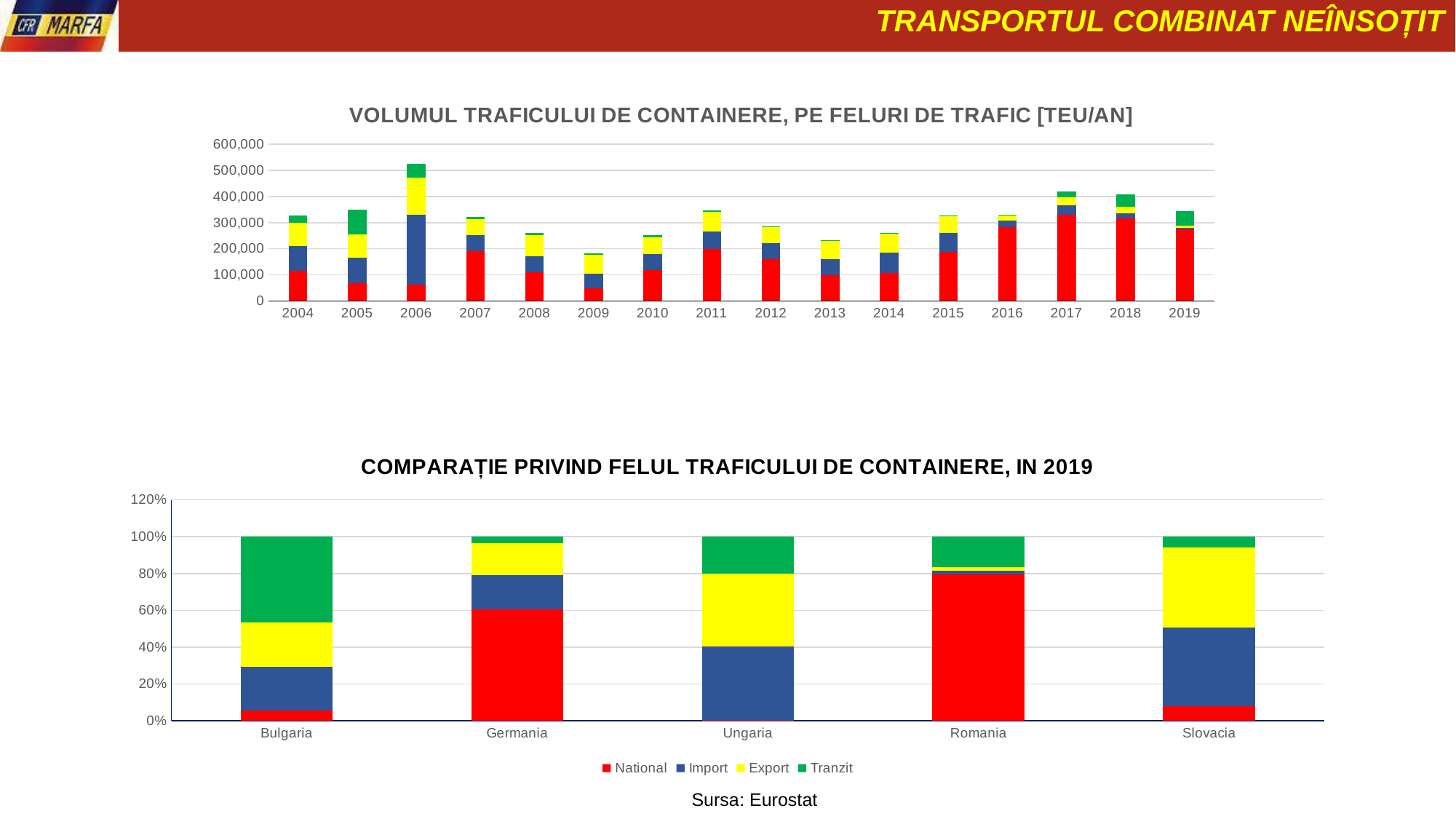
In the bottom chart, 'COMPARAȚIE PRIVIND FELUL TRAFICULUI DE CONTAINERE, IN 2019', which country has the largest National share? Romania What kind of chart is the top chart, 'VOLUMUL TRAFICULUI DE CONTAINERE, PE FELURI DE TRAFIC [TEU/AN]'? Stacked bar chart In the bottom chart, 'COMPARAȚIE PRIVIND FELUL TRAFICULUI DE CONTAINERE, IN 2019', which country has the larger Tranzit share: Bulgaria or Germania? Bulgaria In the top chart, 'VOLUMUL TRAFICULUI DE CONTAINERE, PE FELURI DE TRAFIC [TEU/AN]', which year has the larger total: 2017 or 2019? 2017 How many years are shown on the x axis of the top chart, 'VOLUMUL TRAFICULUI DE CONTAINERE, PE FELURI DE TRAFIC [TEU/AN]'? 16 In the bottom chart, 'COMPARAȚIE PRIVIND FELUL TRAFICULUI DE CONTAINERE, IN 2019', which colour represents the Export series? Yellow How many countries are shown in the bottom chart, 'COMPARAȚIE PRIVIND FELUL TRAFICULUI DE CONTAINERE, IN 2019'? 5 How many series does the legend of the bottom chart, 'COMPARAȚIE PRIVIND FELUL TRAFICULUI DE CONTAINERE, IN 2019', list? 4 In the top chart, 'VOLUMUL TRAFICULUI DE CONTAINERE, PE FELURI DE TRAFIC [TEU/AN]', is the total for 2009 greater or less than 200,000? less In the top chart, 'VOLUMUL TRAFICULUI DE CONTAINERE, PE FELURI DE TRAFIC [TEU/AN]', which year has the highest total container traffic? 2006 In the top chart, 'VOLUMUL TRAFICULUI DE CONTAINERE, PE FELURI DE TRAFIC [TEU/AN]', is the total for 2006 greater or less than 500,000? greater In the top chart, 'VOLUMUL TRAFICULUI DE CONTAINERE, PE FELURI DE TRAFIC [TEU/AN]', which year has the lowest total container traffic? 2009